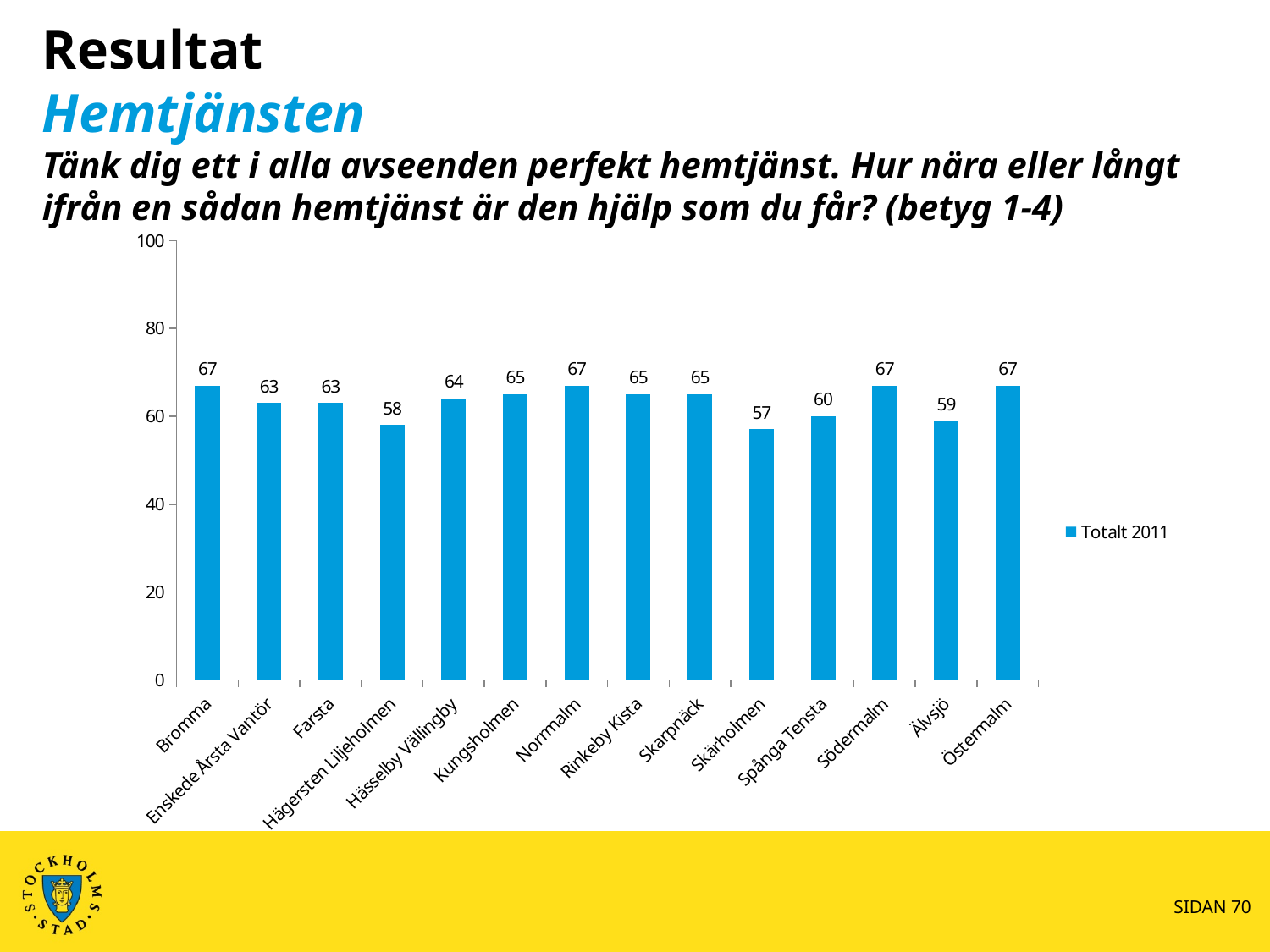
Which is larger, the value for Kungsholmen or the value for Hägersten Liljeholmen? Kungsholmen What is the value for Bromma? 67 Which category has the lowest value? Skärholmen How many categories are shown on the x axis? 14 What is the value for Hägersten Liljeholmen? 58 What is the difference between the values for Norrmalm and Skärholmen? 10 Is the value for Södermalm greater or less than 60? greater How many series does the legend list? 1 What is the value for Älvsjö? 59 What kind of chart is shown on the slide? Bar chart What is the value for Spånga Tensta? 60 What is the difference between the values for Hässelby Vällingby and Farsta? 1